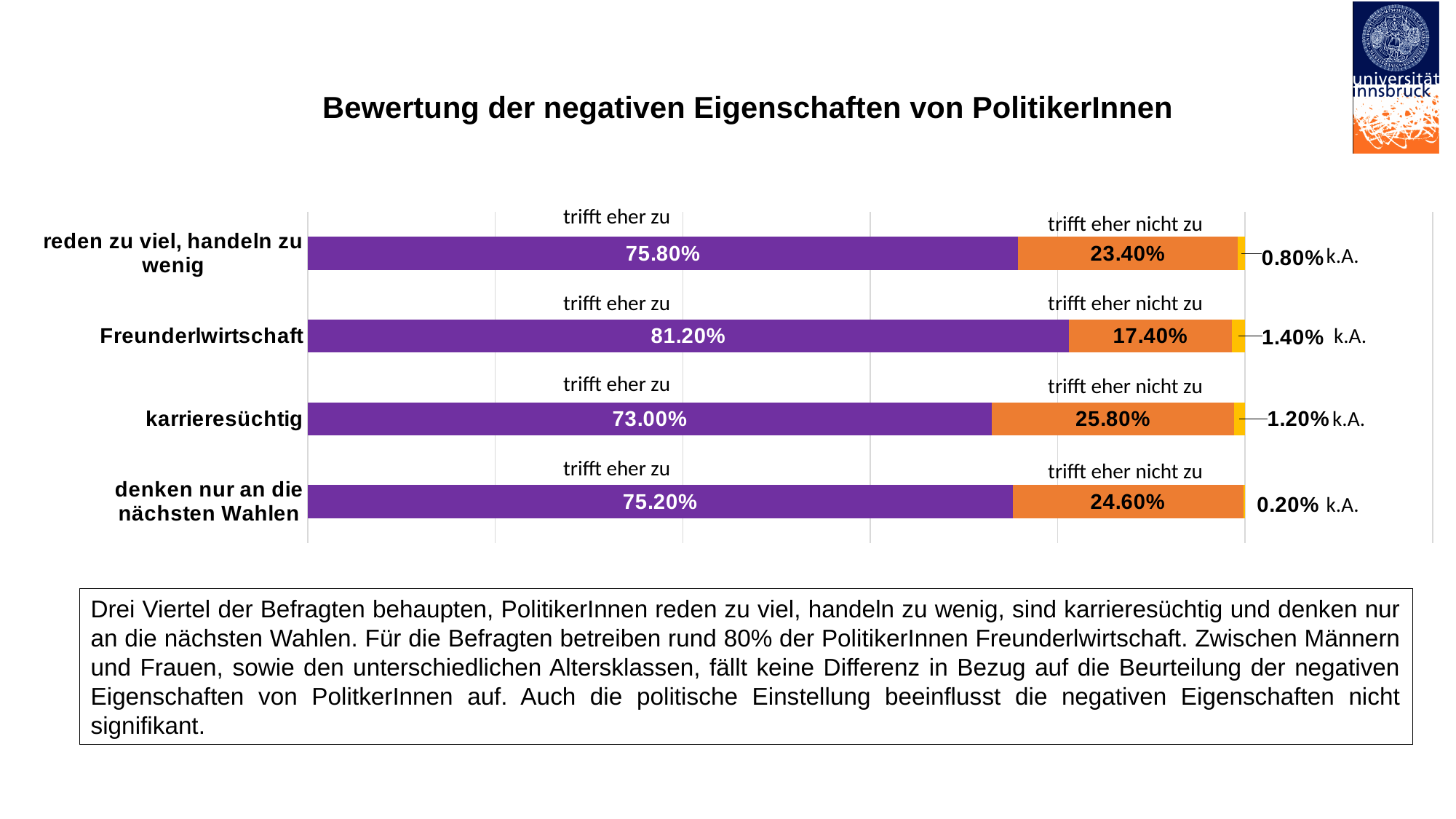
How many categories are shown in the chart? 4 Which category has the lowest 'trifft eher zu' value? karrieresüchtig What is the 'k.A.' value for 'denken nur an die nächsten Wahlen'? 0.20% What is the 'trifft eher zu' value for Freunderlwirtschaft? 81.20% What kind of chart is shown on the slide? Stacked bar chart Which category has the highest 'k.A.' value? Freunderlwirtschaft What is the 'trifft eher nicht zu' value for karrieresüchtig? 25.80% Which is larger: the 'trifft eher nicht zu' value for 'denken nur an die nächsten Wahlen' or for 'reden zu viel, handeln zu wenig'? denken nur an die nächsten Wahlen What is the difference between the 'trifft eher zu' values for Freunderlwirtschaft and karrieresüchtig? 8.20% What is the 'trifft eher zu' value for 'reden zu viel, handeln zu wenig'? 75.80% What is the title of the chart? Bewertung der negativen Eigenschaften von PolitikerInnen Which category has the highest 'trifft eher zu' value? Freunderlwirtschaft